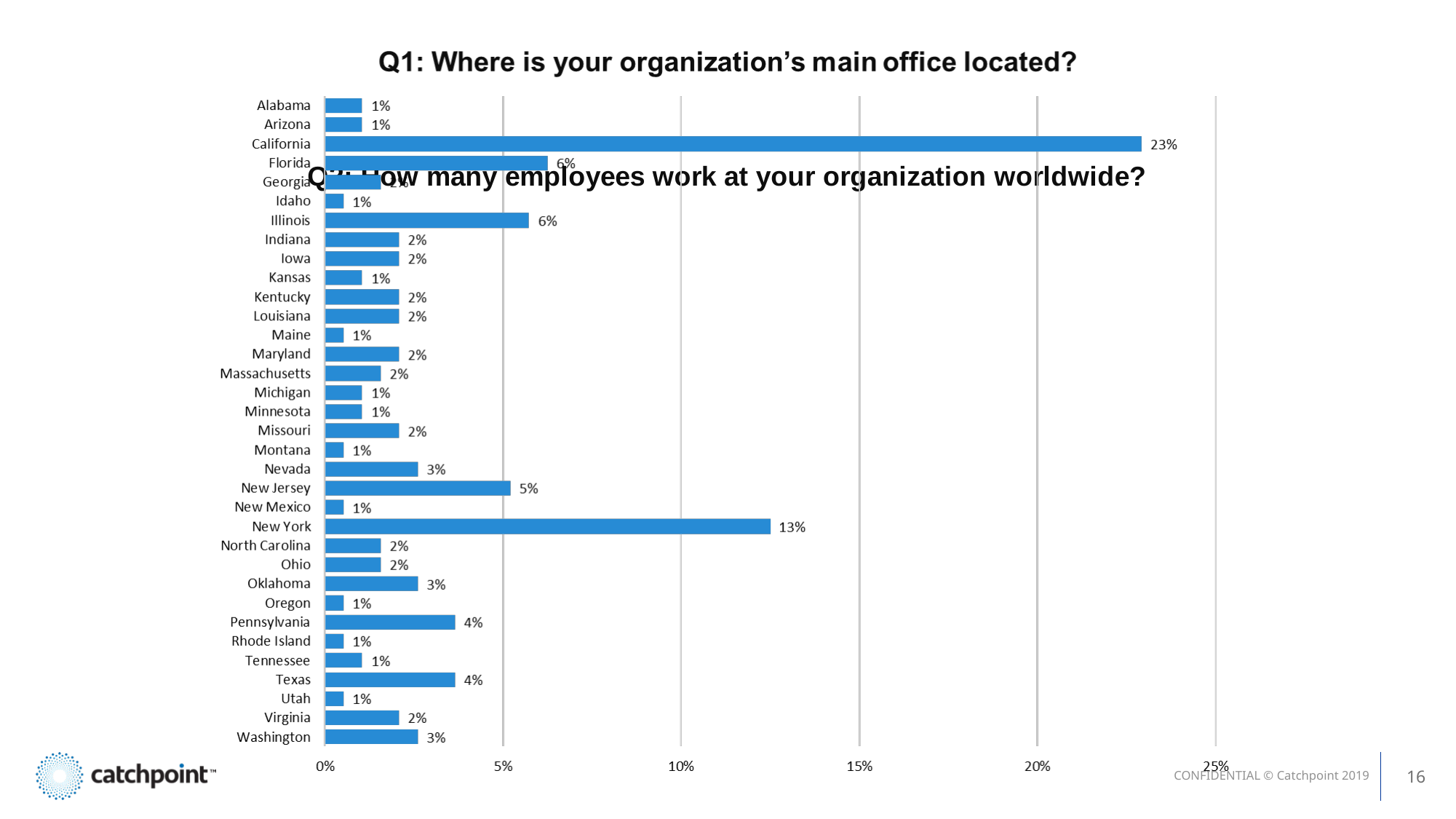
Is the value for Texas greater or less than 5%? less Which is larger, the value for Illinois or the value for Nevada? Illinois What is the value for New York? 13% What is the value for Pennsylvania? 4% What kind of chart is shown on the slide? Bar chart What is the difference between the values for California and New York? 10% How many states are listed on the chart? 34 Is the value for New York greater or less than 10%? greater What is the title of the chart? Q1: Where is your organization's main office located? Which state has the highest value? California What is the value for New Jersey? 5% What is the value for California? 23%